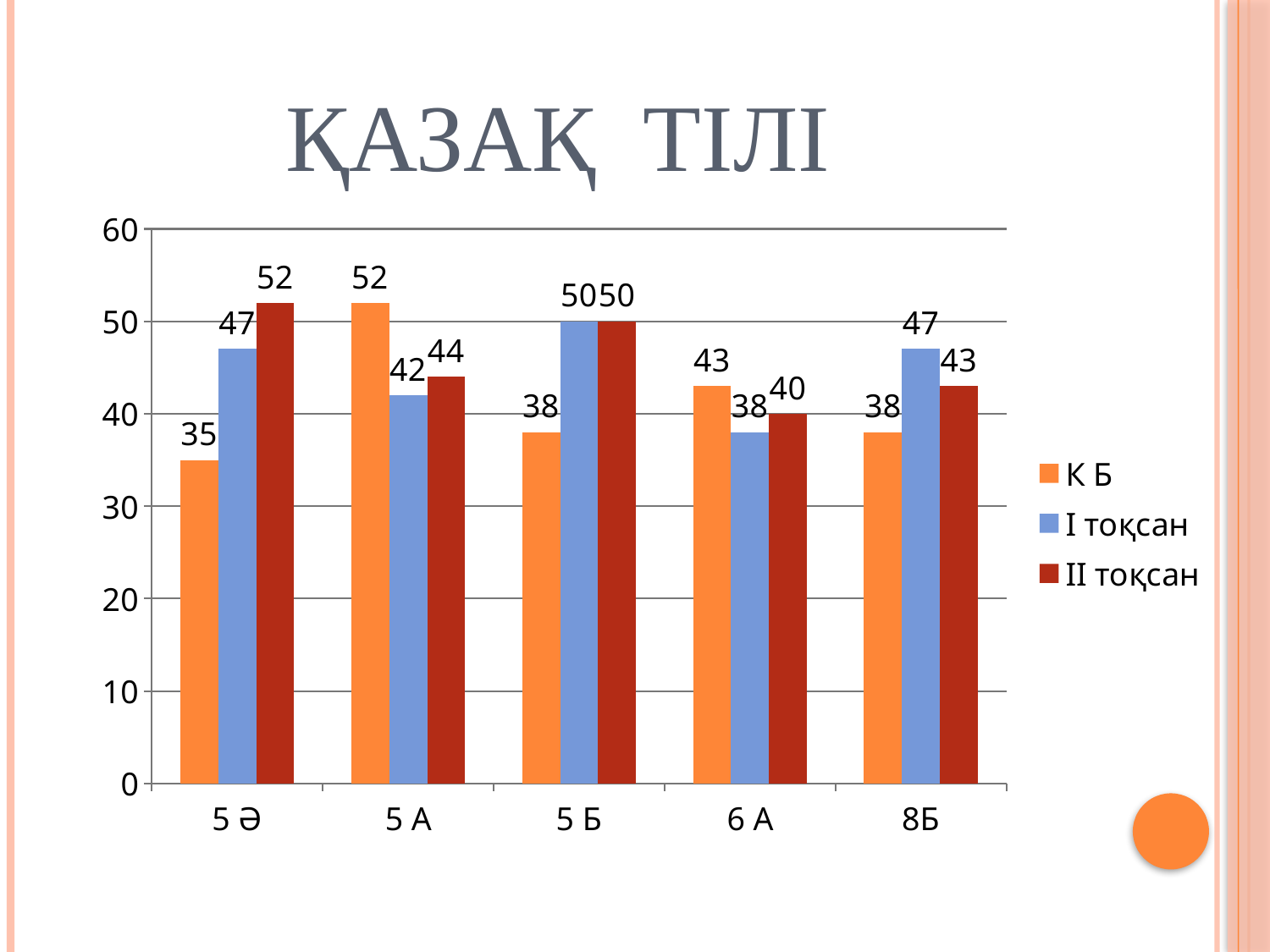
What is the difference between the II тоқсан and К Б values for 5 Ә? 17 Which category has the lowest I тоқсан value? 6 А Which is larger for 6 А: К Б or II тоқсан? К Б How many series does the legend list? 3 Is the I тоқсан value for 5 Б greater or less than 40? greater Which category has the highest К Б value? 5 А What is the value of II тоқсан for 5 А? 44 What is the title of the slide? ҚАЗАҚ ТІЛІ What kind of chart is shown on the slide? bar chart How many categories are shown on the x axis? 5 What is the value of К Б for 5 Ә? 35 What is the value of I тоқсан for 8Б? 47